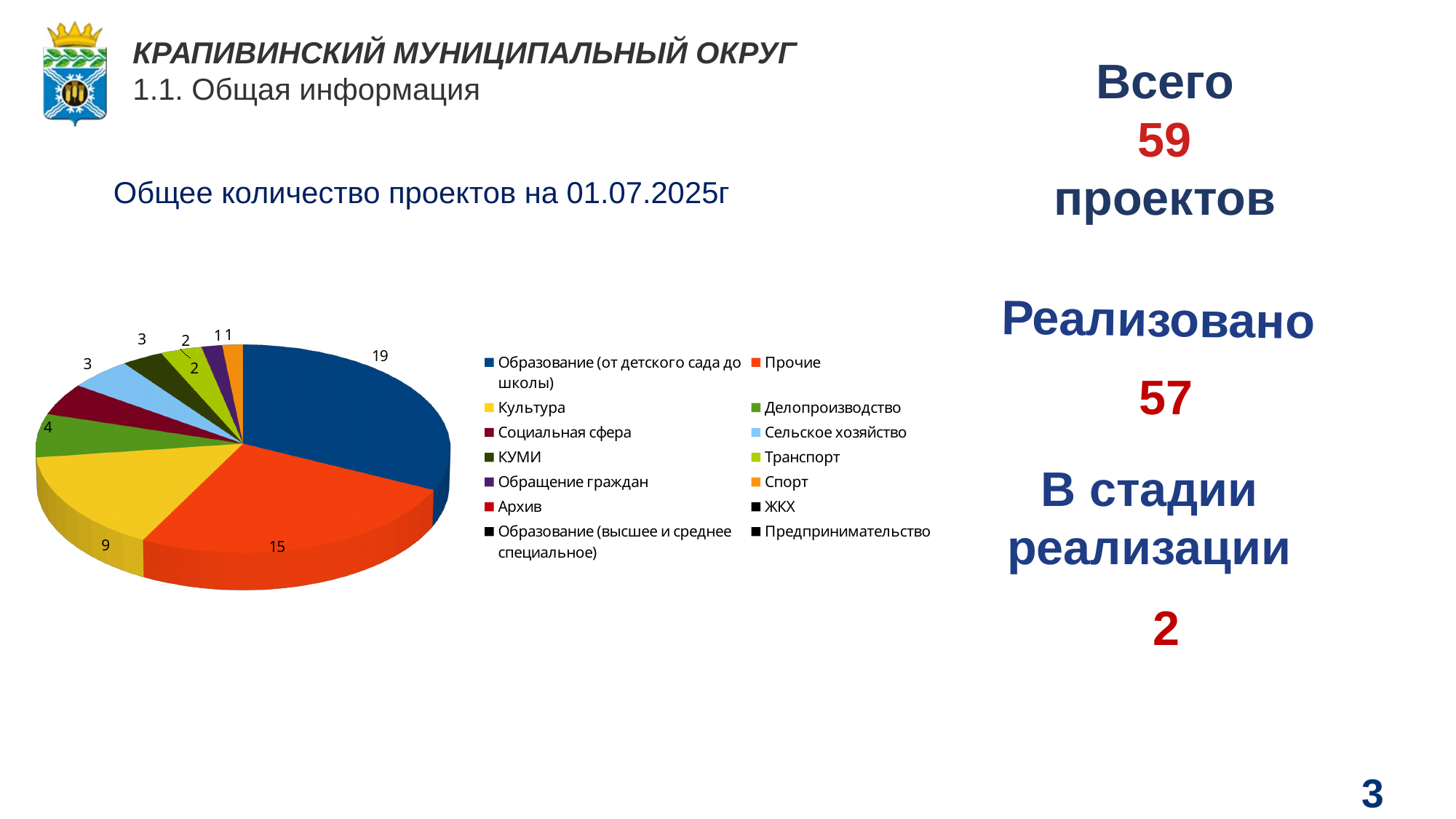
What is the value for Культура in the pie chart? 9 What is the title above the pie chart? Общее количество проектов на 01.07.2025г What is the value for Прочие in the pie chart? 15 Which category has the largest slice in the pie chart? Образование (от детского сада до школы) What is the difference between the values for Образование (от детского сада до школы) and Прочие? 4 What type of chart is shown on the slide? Pie chart What is the value for Образование (от детского сада до школы) in the pie chart? 19 How many entries does the legend of the pie chart list? 14 Which is larger in the pie chart, Прочие or Культура? Прочие What colour is the slice for Образование (от детского сада до школы)? Dark blue What is the difference between the values for Культура and Делопроизводство? 5 What is the value for Делопроизводство in the pie chart? 4